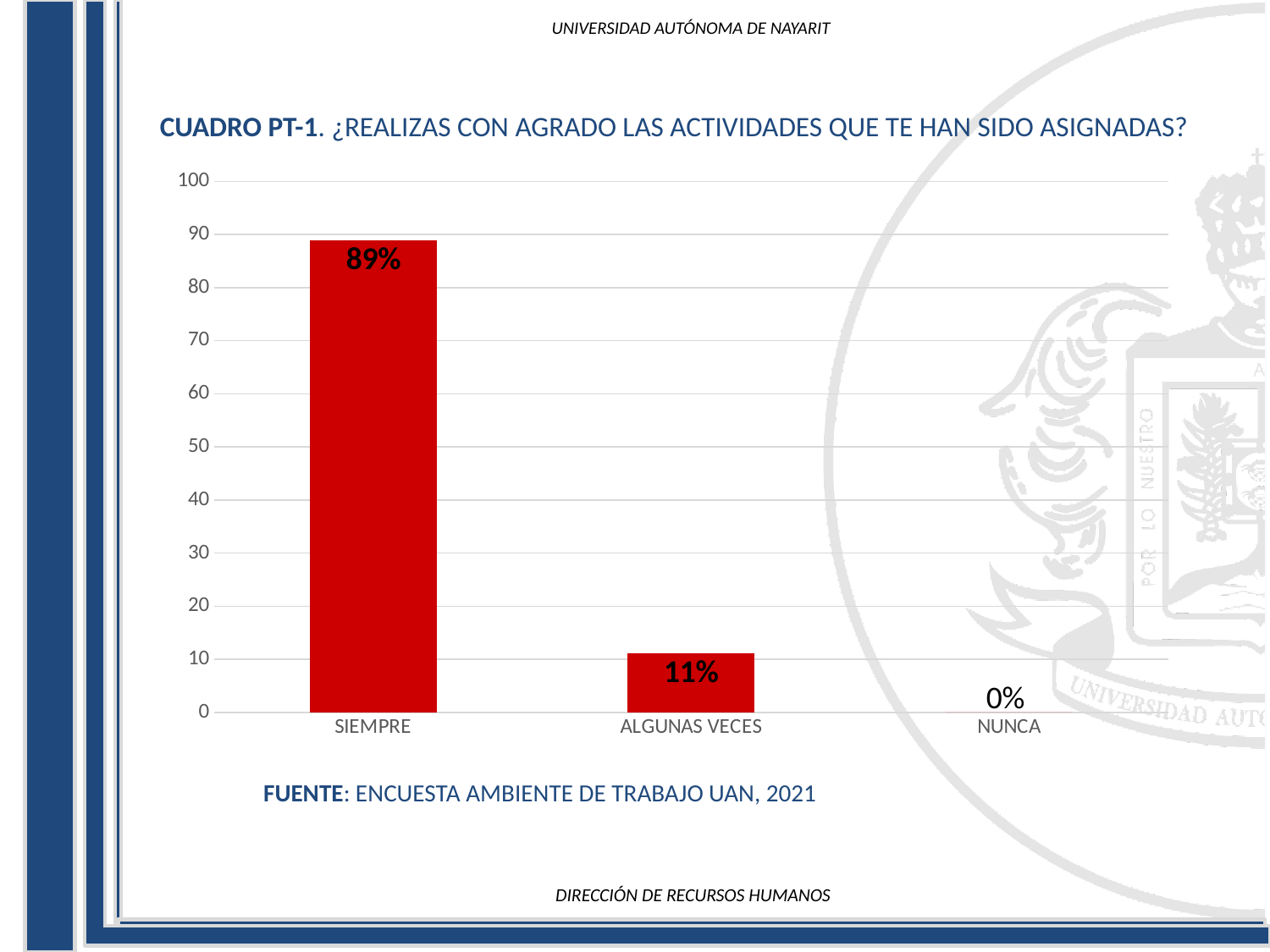
Which category has the lowest value? NUNCA What source is cited below the chart? ENCUESTA AMBIENTE DE TRABAJO UAN, 2021 How many categories are shown on the x axis? 3 Which is larger, the value for ALGUNAS VECES or the value for NUNCA? ALGUNAS VECES What is the value for NUNCA? 0% What is the value for SIEMPRE? 89% Is the value for SIEMPRE greater or less than 80? greater Is the value for ALGUNAS VECES greater or less than 20? less What is the value for ALGUNAS VECES? 11% What is the difference between the values for SIEMPRE and ALGUNAS VECES? 78% What kind of chart is shown on the slide? bar chart Which category has the highest value? SIEMPRE